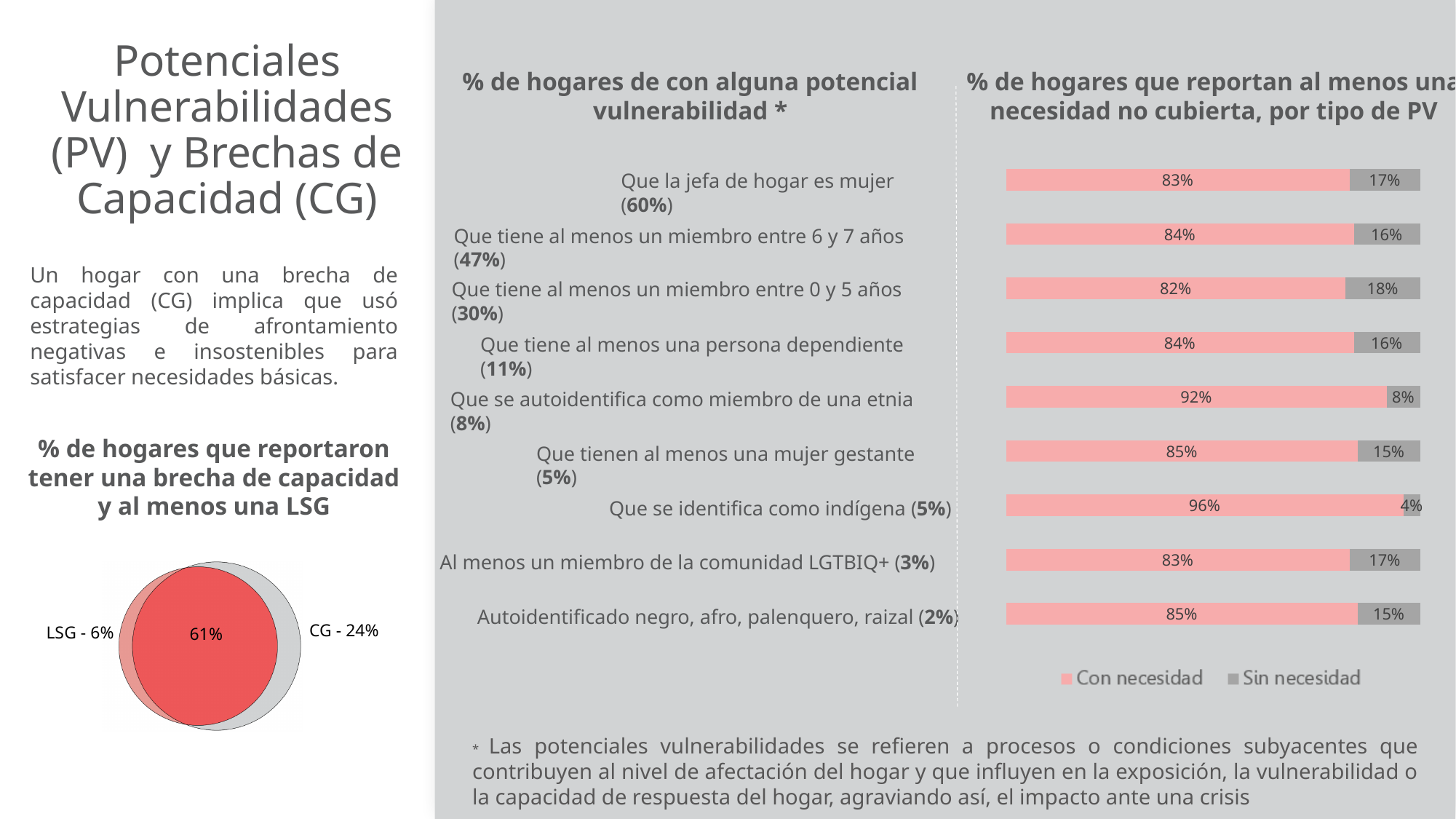
In the chart '% de hogares que reportan al menos una necesidad no cubierta, por tipo de PV', which category has the lowest 'Sin necesidad' value? Que se identifica como indígena In the chart '% de hogares que reportan al menos una necesidad no cubierta, por tipo de PV', what is the 'Sin necesidad' value for 'Que tiene al menos un miembro entre 0 y 5 años'? 18% In the chart '% de hogares que reportan al menos una necesidad no cubierta, por tipo de PV', what is the 'Con necesidad' value for 'Que se identifica como indígena'? 96% In the chart '% de hogares que reportan al menos una necesidad no cubierta, por tipo de PV', which category has the highest 'Con necesidad' value? Que se identifica como indígena What kind of chart is '% de hogares que reportan al menos una necesidad no cubierta, por tipo de PV'? Stacked bar chart In the chart '% de hogares que reportan al menos una necesidad no cubierta, por tipo de PV', which category has the highest 'Sin necesidad' value? Que tiene al menos un miembro entre 0 y 5 años In the chart '% de hogares que reportan al menos una necesidad no cubierta, por tipo de PV', what are the two legend entries? Con necesidad, Sin necesidad How many categories are shown in the chart '% de hogares que reportan al menos una necesidad no cubierta, por tipo de PV'? 9 How many series does the legend list in the chart '% de hogares que reportan al menos una necesidad no cubierta, por tipo de PV'? 2 In the chart '% de hogares que reportan al menos una necesidad no cubierta, por tipo de PV', what is the difference between the 'Con necesidad' values for 'Que se identifica como indígena' and 'Que se autoidentifica como miembro de una etnia'? 4% In the chart '% de hogares que reportan al menos una necesidad no cubierta, por tipo de PV', what is the 'Con necesidad' value for 'Que la jefa de hogar es mujer'? 83% In the chart '% de hogares que reportan al menos una necesidad no cubierta, por tipo de PV', which has a larger 'Con necesidad' value: 'Que tienen al menos una mujer gestante' or 'Que tiene al menos un miembro entre 0 y 5 años'? Que tienen al menos una mujer gestante